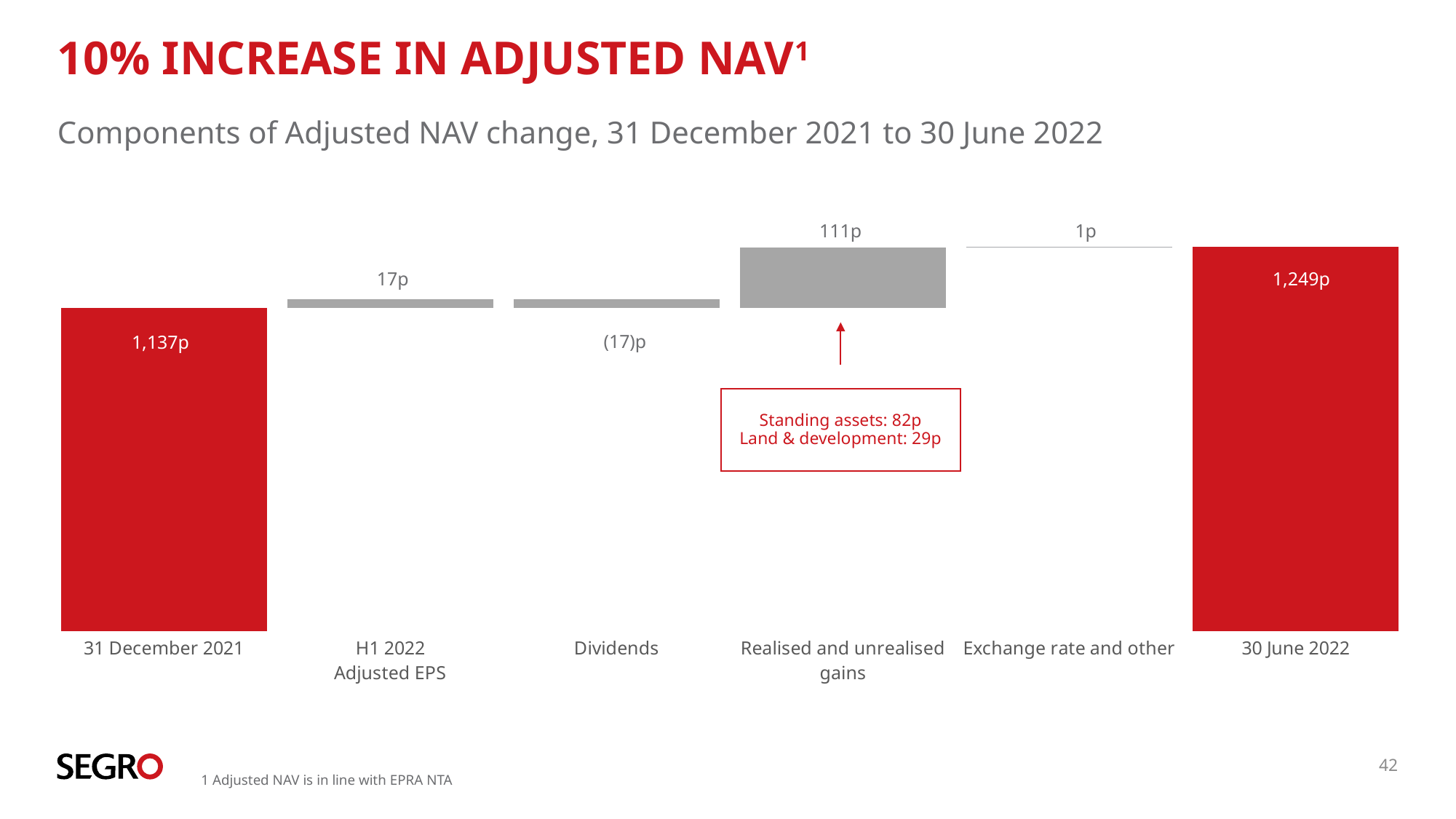
Which component contributes the largest positive change to Adjusted NAV? Realised and unrealised gains What value is shown for Realised and unrealised gains? 111p According to the callout box, how much of the Realised and unrealised gains comes from standing assets? 82p What is the Adjusted NAV value shown for 30 June 2022? 1,249p Which is larger, the value for Realised and unrealised gains or the value for H1 2022 Adjusted EPS? Realised and unrealised gains What value is shown for H1 2022 Adjusted EPS? 17p What value is shown for Exchange rate and other? 1p What is the title of the chart? Components of Adjusted NAV change, 31 December 2021 to 30 June 2022 What is the Adjusted NAV value shown for 31 December 2021? 1,137p How many categories are shown along the x axis of the chart? 6 What is the difference between the 30 June 2022 and 31 December 2021 Adjusted NAV values? 112p What value is shown for Dividends? (17)p